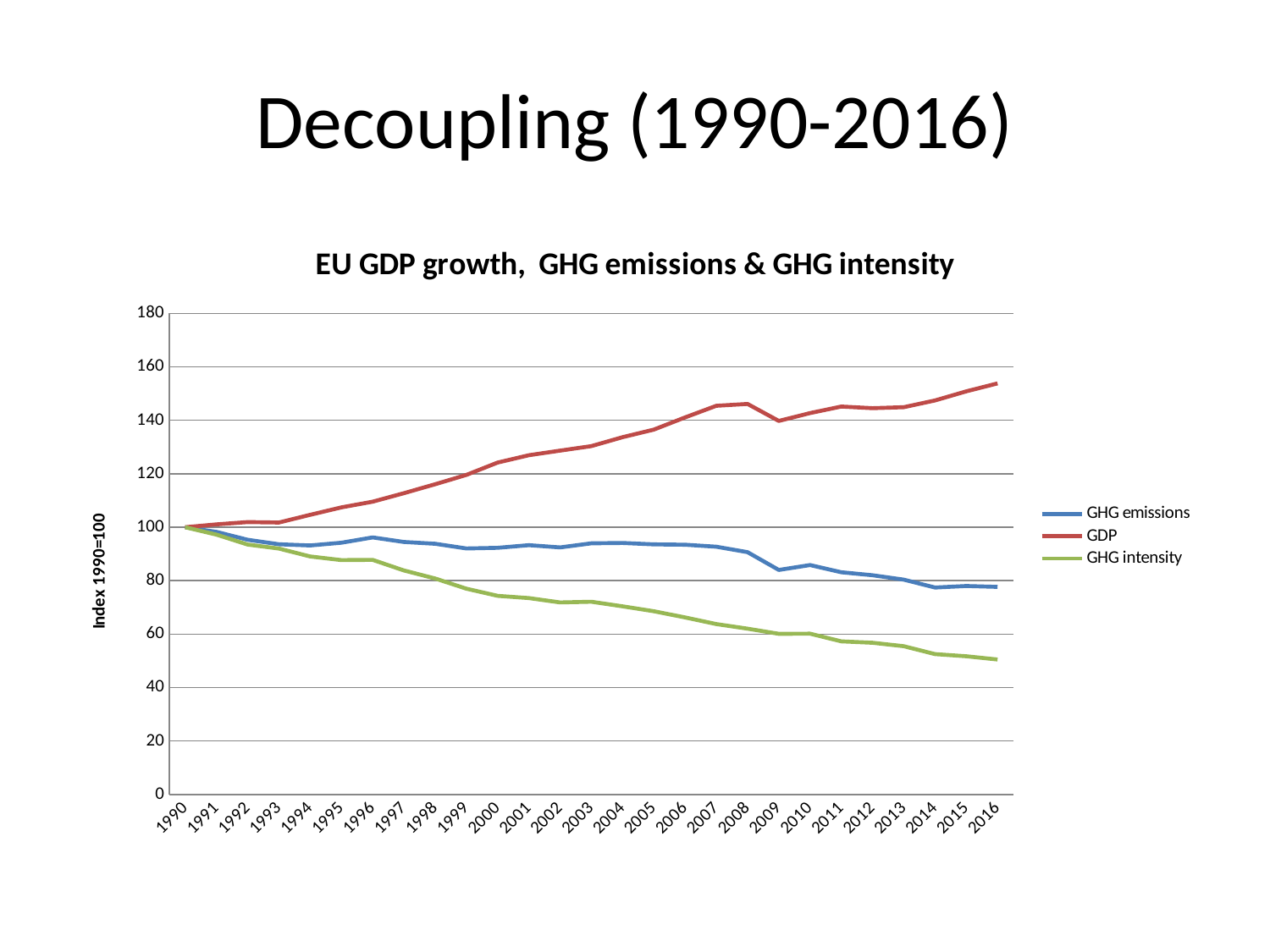
Which series has the lowest value in 2016? GHG intensity Is the value for GDP in 2005 greater or less than 120? greater How many series does the legend list? 3 Is the value for GDP in 2016 greater or less than 140? greater How many years are plotted along the x axis? 27 What is the label on the vertical axis? Index 1990=100 Is the value for GHG intensity in 2016 greater or less than 60? less What is the value of GDP in 1990? 100 Which series has the highest value in 2016? GDP Does the GHG intensity line rise or fall from 1990 to 2016? fall What kind of chart is shown on the slide? line chart What is the value of GHG intensity in 1990? 100